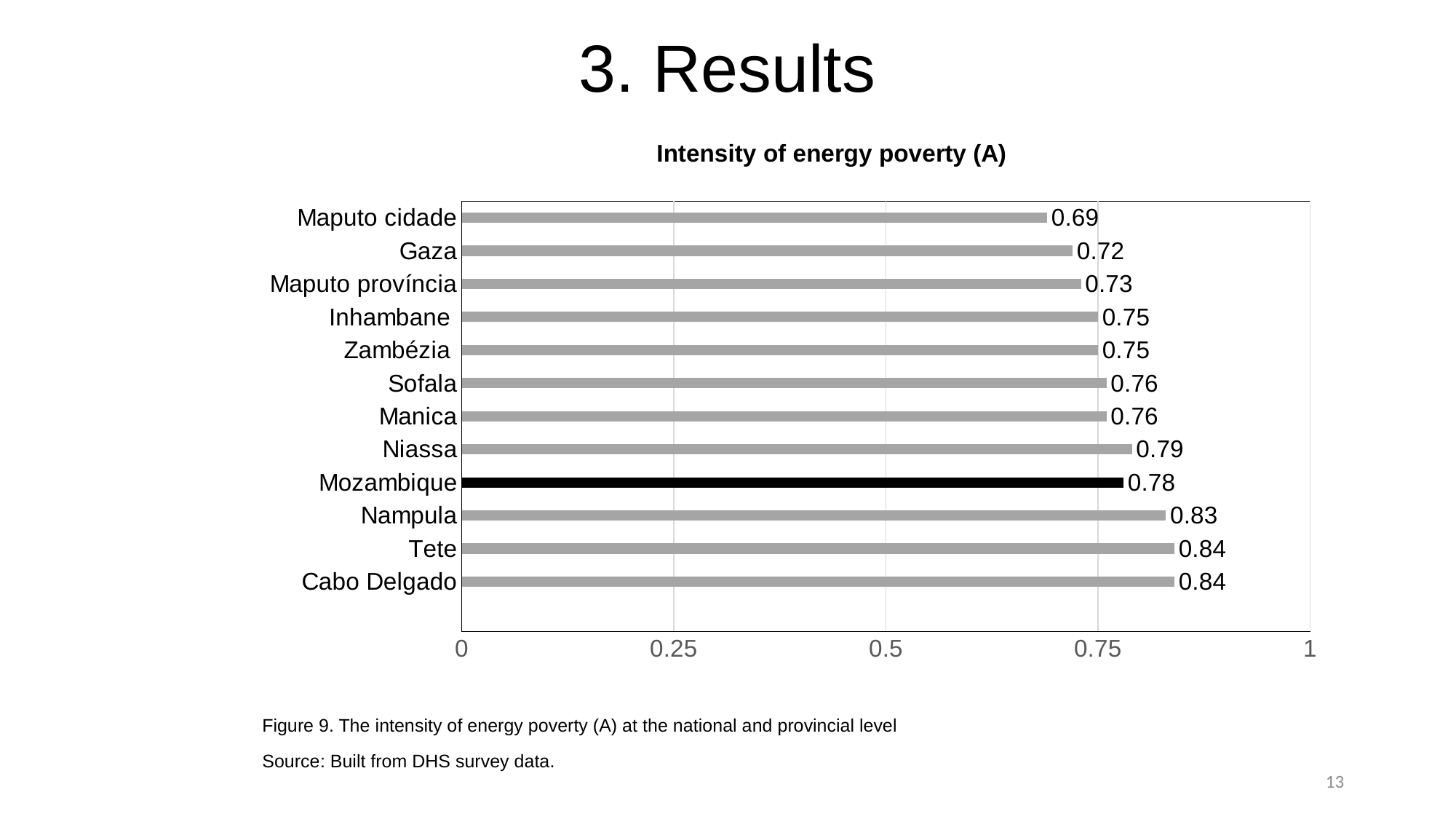
What is the highest value shown on the chart? 0.84 What is the value shown for Maputo cidade? 0.69 What kind of chart is shown on the slide? Bar chart Is the value for Tete greater or less than 0.75? greater How many categories are shown on the chart? 12 Which category has the lowest intensity of energy poverty? Maputo cidade What is the difference between the values for Cabo Delgado and Maputo cidade? 0.15 What is the title of the chart? Intensity of energy poverty (A) What is the difference between the values for Nampula and Mozambique? 0.05 Which is larger, the value for Gaza or the value for Niassa? Niassa What is the intensity of energy poverty (A) for Mozambique? 0.78 What is the value shown for Niassa? 0.79